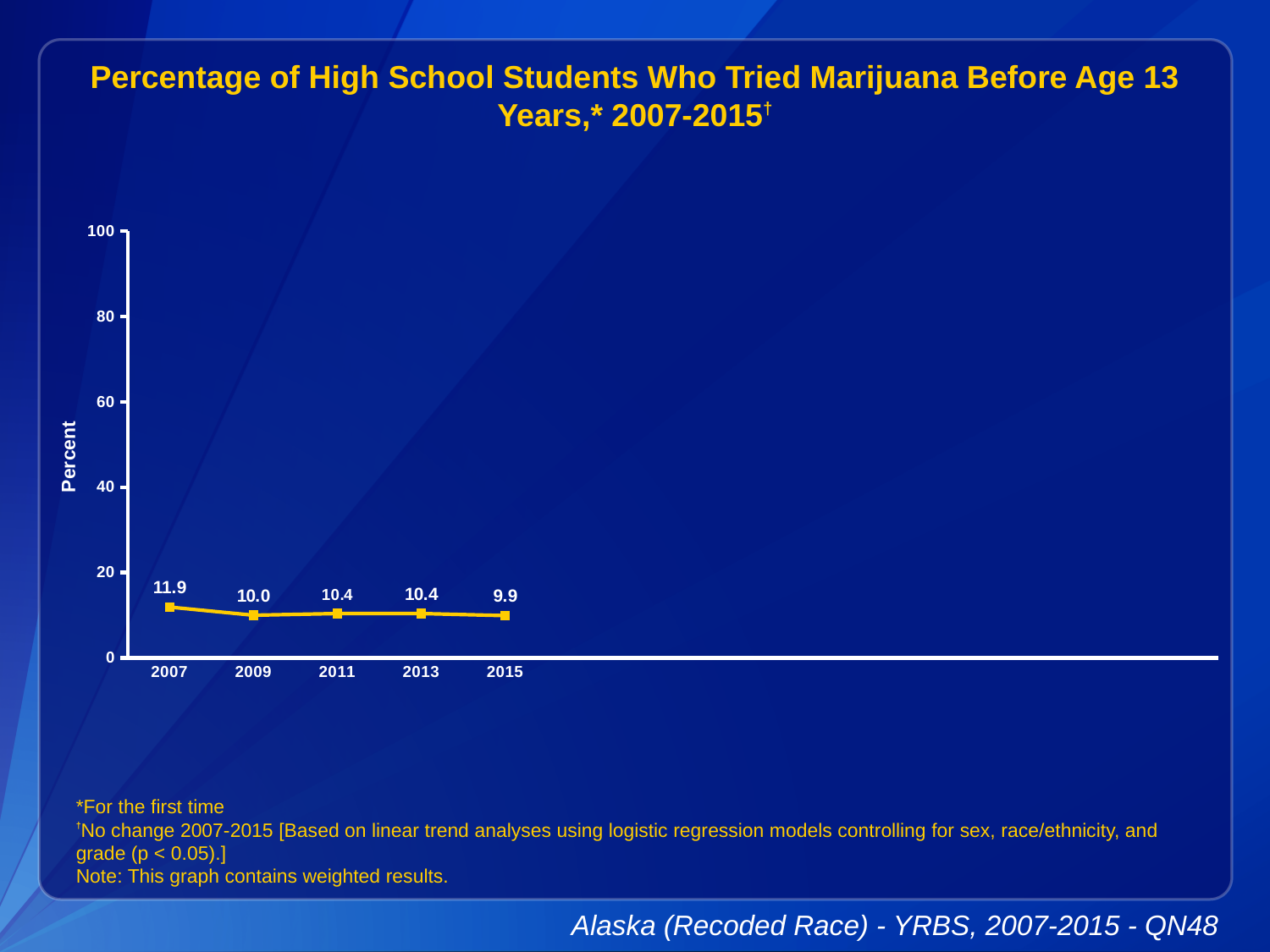
Do the values generally rise or fall from 2007 to 2015? fall Is the value for 2013 greater or less than 20? less How many years are plotted on the chart? 5 Which year has the highest value? 2007 Which is larger, the value for 2007 or the value for 2011? 2007 Which year has the lowest value? 2015 What kind of chart is shown? line chart What is the value for 2007? 11.9 What is the value for 2015? 9.9 What is the label on the y axis? Percent What is the value for 2009? 10.0 What is the difference between the values for 2007 and 2015? 2.0